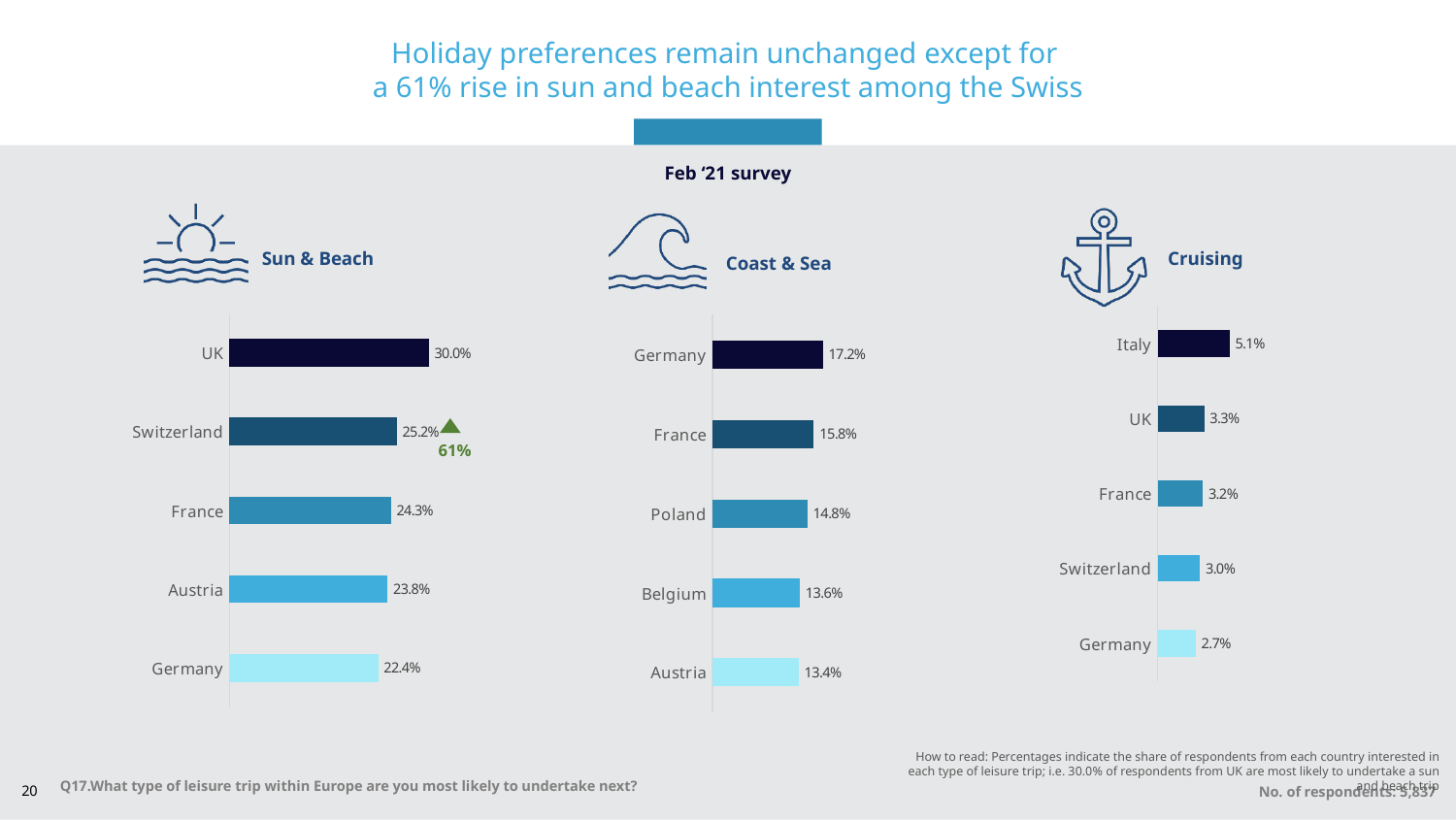
In the Sun & Beach chart, which country has the highest value? UK In the Sun & Beach chart, what is the value for Switzerland? 25.2% In the Cruising chart, what is the difference between the values for Italy and UK? 1.8% What kind of chart is the Coast & Sea chart? Bar chart In the Cruising chart, what is the value for Germany? 2.7% In the Cruising chart, which country has the highest value? Italy In the Coast & Sea chart, what is the value for Poland? 14.8% In the Sun & Beach chart, what is the difference between the values for UK and Germany? 7.6% In the Coast & Sea chart, which country has the lowest value? Austria How many countries are shown in the Cruising chart? 5 In the Coast & Sea chart, which is larger, the value for Germany or the value for Belgium? Germany In the Sun & Beach chart, what percentage rise is annotated next to the Switzerland bar? 61%